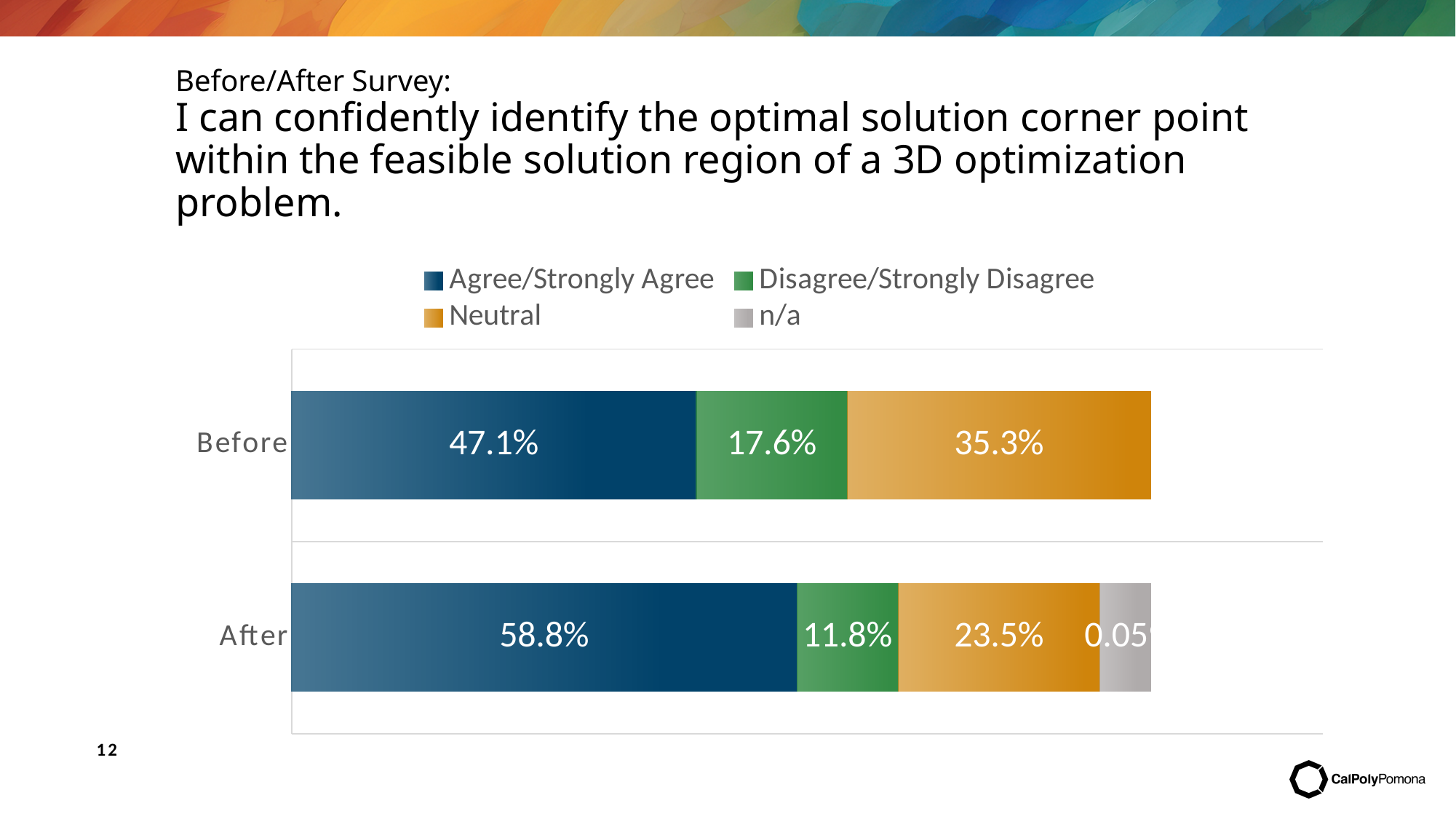
What is the Agree/Strongly Agree value for After? 58.8% Which category has the higher Agree/Strongly Agree value, Before or After? After What is the Agree/Strongly Agree value for Before? 47.1% How many series does the legend list? 4 What is the Neutral value for After? 23.5% What is the difference between the Agree/Strongly Agree values for After and Before? 11.7% What is the Neutral value for Before? 35.3% What kind of chart is shown on the slide? Stacked bar chart What is the difference between the Disagree/Strongly Disagree values for Before and After? 5.8% Which legend entry is shown in grey? n/a How many categories (bars) are plotted on the chart? 2 What is the Disagree/Strongly Disagree value for After? 11.8%